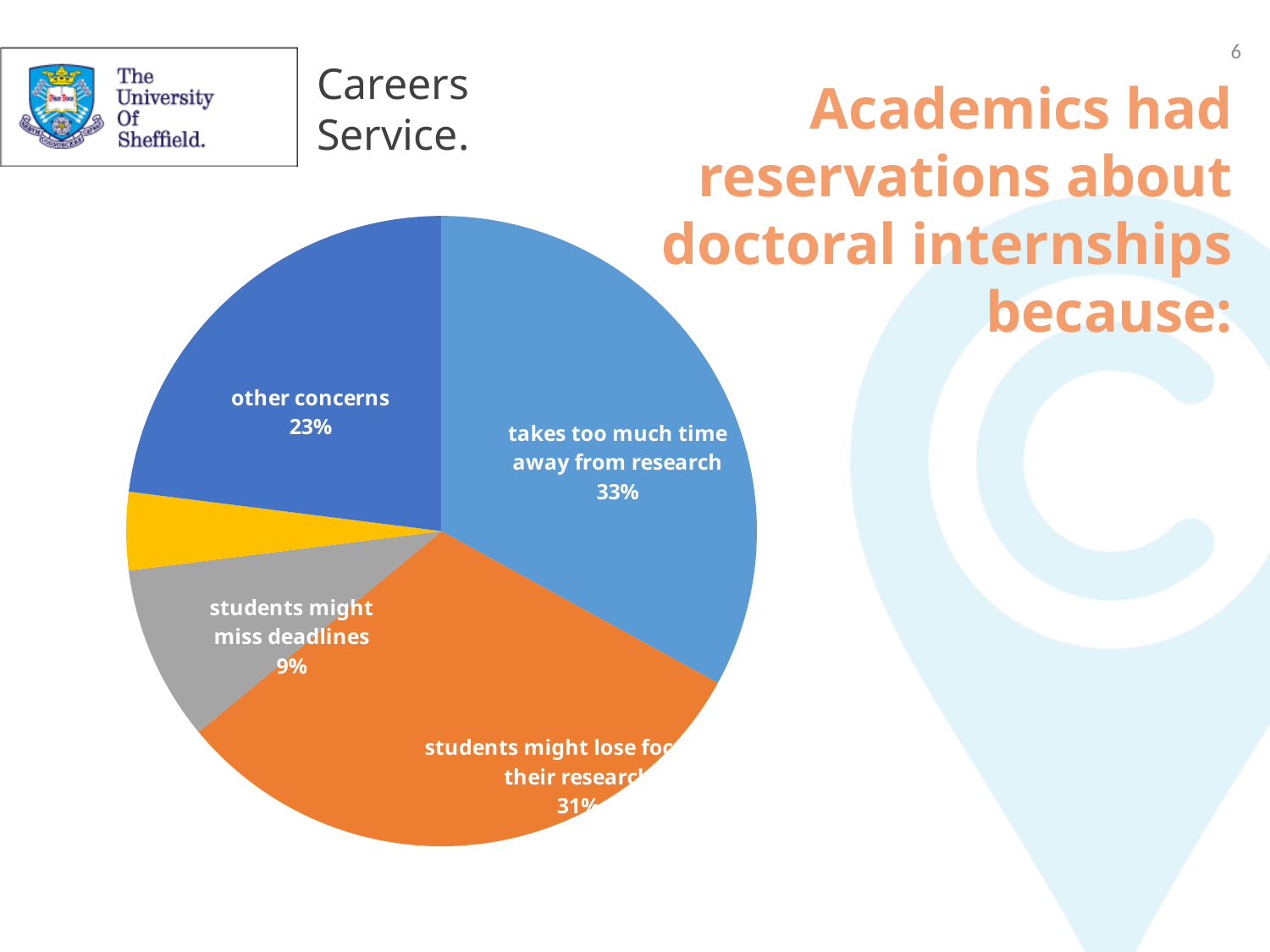
Which labelled slice has the largest share of the pie? takes too much time away from research What percentage of the pie is 'takes too much time away from research'? 33% What is the difference in percentage points between 'other concerns' and 'students might miss deadlines'? 14 What colour is the 'students might miss deadlines' slice? grey What percentage is shown on the orange slice of the pie? 31% How many slices does the pie chart have? 5 What is the difference in percentage points between 'takes too much time away from research' and 'other concerns'? 10 What kind of chart is shown on the slide? pie chart What percentage of the pie is 'students might miss deadlines'? 9% What percentage of the pie is 'other concerns'? 23% What is the title text on the slide next to the pie chart? Academics had reservations about doctoral internships because: Which is larger: 'other concerns' or 'students might miss deadlines'? other concerns